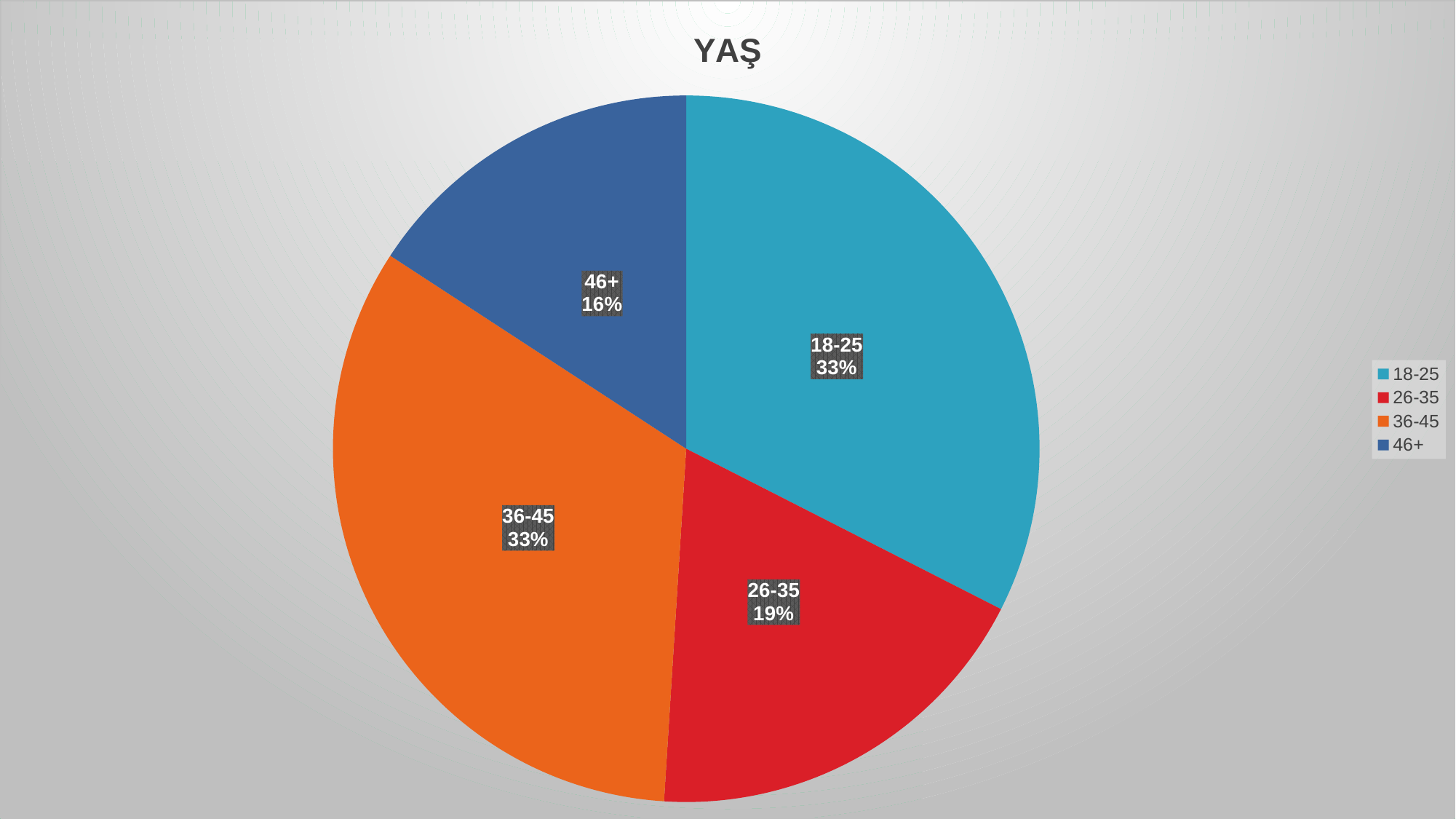
What is the value shown for the 36-45 slice? 33% Which slice is larger, 36-45 or 26-35? 36-45 What percentage of the pie does the 18-25 slice represent? 33% Which age group has the smallest slice of the pie? 46+ What is the difference in percentage points between the 26-35 slice and the 46+ slice? 3 What is the difference in percentage points between the 18-25 slice and the 26-35 slice? 14 Which slice is larger, 26-35 or 46+? 26-35 What is the value shown for the 46+ slice? 16% What is the title of the chart? YAŞ How many slices does the pie chart have? 4 What type of chart is shown on the slide? Pie chart What is the value shown for the 26-35 slice? 19%